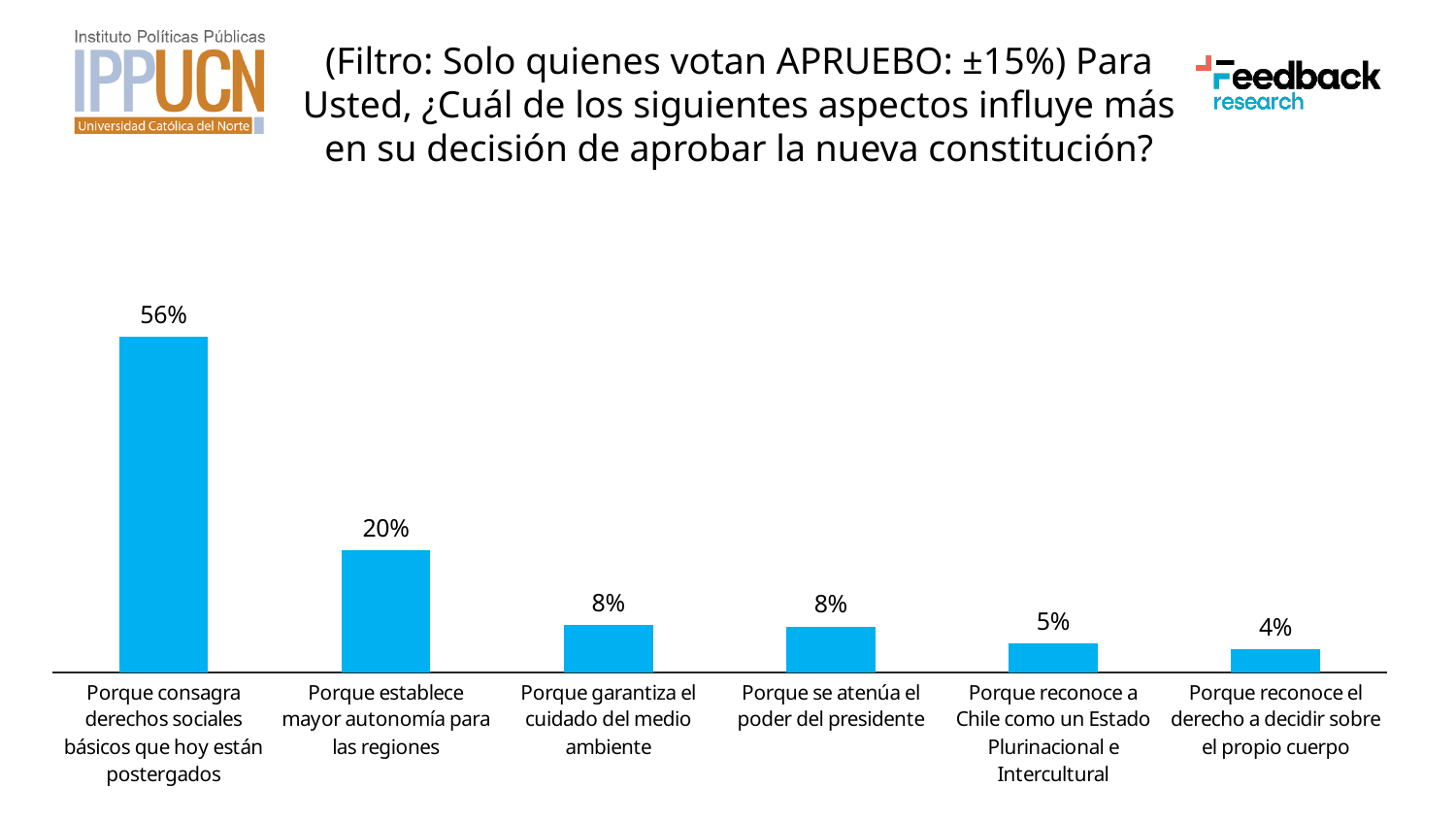
What percentage is shown for "Porque reconoce a Chile como un Estado Plurinacional e Intercultural"? 5% What kind of chart is shown on the slide? Bar chart Do the values rise or fall from left to right along the x axis? Fall What percentage is shown for "Porque consagra derechos sociales básicos que hoy están postergados"? 56% Which is larger: the value for "Porque establece mayor autonomía para las regiones" or for "Porque garantiza el cuidado del medio ambiente"? Porque establece mayor autonomía para las regiones What percentage is shown for "Porque reconoce el derecho a decidir sobre el propio cuerpo"? 4% Which category has the lowest value? Porque reconoce el derecho a decidir sobre el propio cuerpo What percentage is shown for "Porque establece mayor autonomía para las regiones"? 20% What is the difference between the values for "Porque se atenúa el poder del presidente" and "Porque reconoce a Chile como un Estado Plurinacional e Intercultural"? 3% Which category has the highest value? Porque consagra derechos sociales básicos que hoy están postergados How many categories are shown in the chart? 6 What is the difference between the values for "Porque consagra derechos sociales básicos que hoy están postergados" and "Porque establece mayor autonomía para las regiones"? 36%